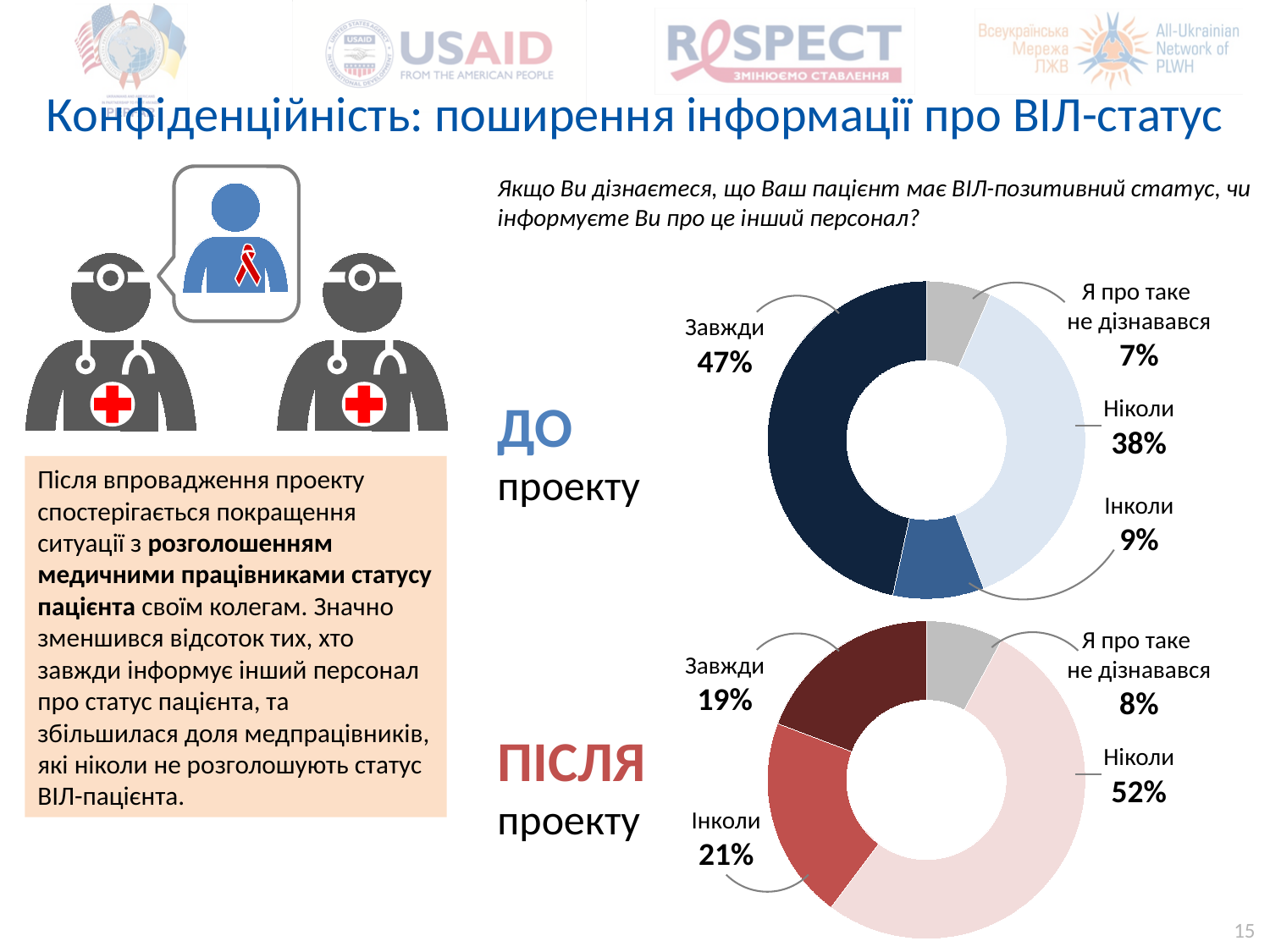
In the "ПІСЛЯ проекту" chart, what is the value for "Ніколи"? 52% In the "ПІСЛЯ проекту" chart, which is larger: "Інколи" or "Завжди"? Інколи What type of chart is used for "ПІСЛЯ проекту"? Donut (pie) chart How many charts are shown on the slide? 2 How many categories does the "ДО проекту" chart show? 4 In the "ПІСЛЯ проекту" chart, what is the value for "Я про таке не дізнавався"? 8% In the "ДО проекту" chart, what is the value for "Завжди"? 47% In the "ПІСЛЯ проекту" chart, what is the combined share of "Інколи" and "Завжди"? 40% What is the difference between the "Завжди" value in the "ДО проекту" chart and the "Завжди" value in the "ПІСЛЯ проекту" chart? 28% In the "ПІСЛЯ проекту" chart, which category has the smallest share? Я про таке не дізнавався In the "ДО проекту" chart, which category has the largest share? Завжди In the "ДО проекту" chart, what is the value for "Інколи"? 9%